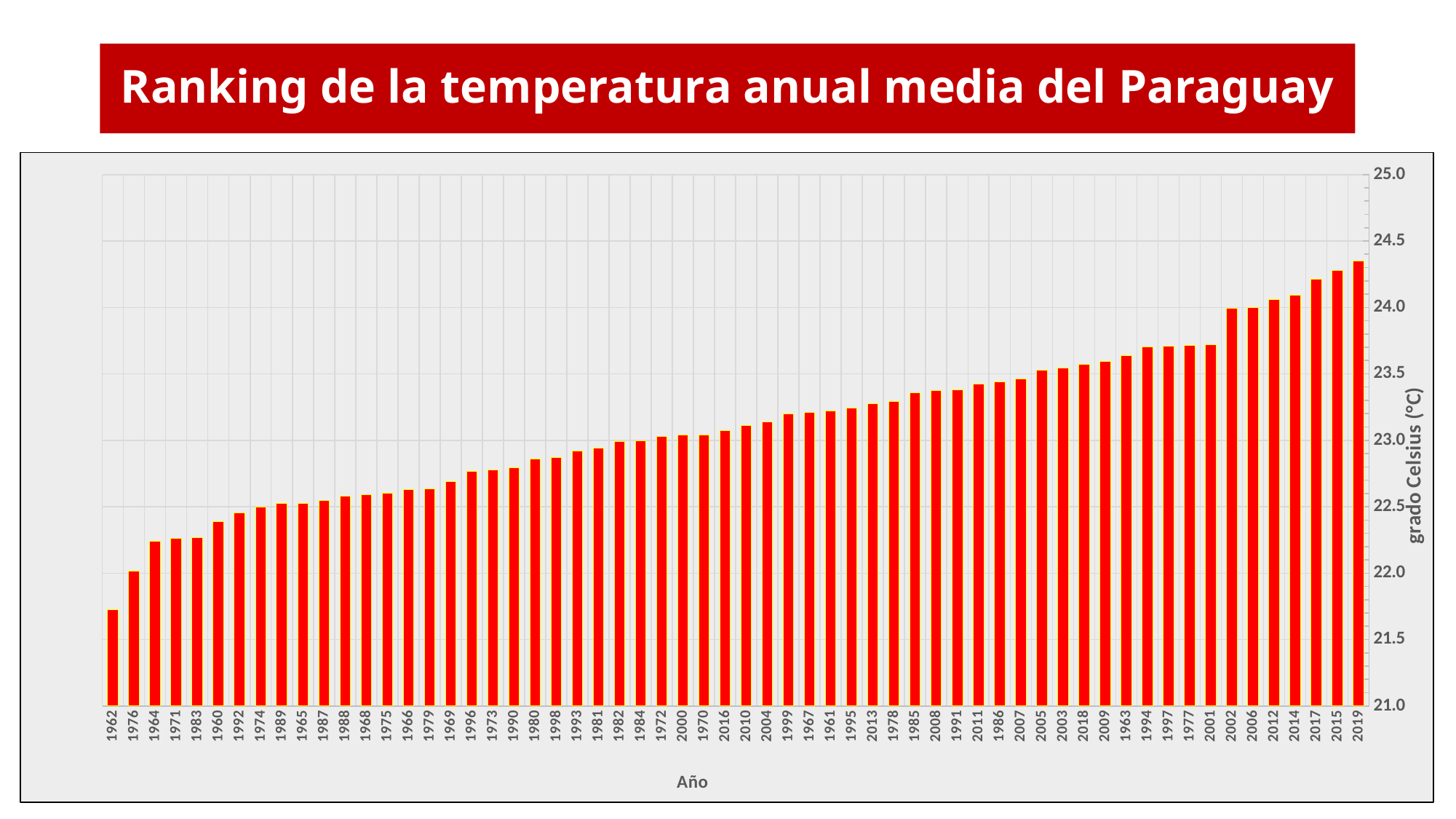
Which year has the highest mean annual temperature in the chart? 2019 Is the value for 1960 greater or less than 22.5? less Is the value for 1963 greater or less than 23.5? greater What is the label of the vertical axis? grado Celsius (°C) What kind of chart is shown on the slide? Bar chart Do the bar values rise or fall from left to right along the x axis? Rise Which has the larger value, 1976 or 2017? 2017 Is the value for 1962 greater or less than 22.0? less How many years (bars) are shown in the chart? 60 Which year has the lowest mean annual temperature in the chart? 1962